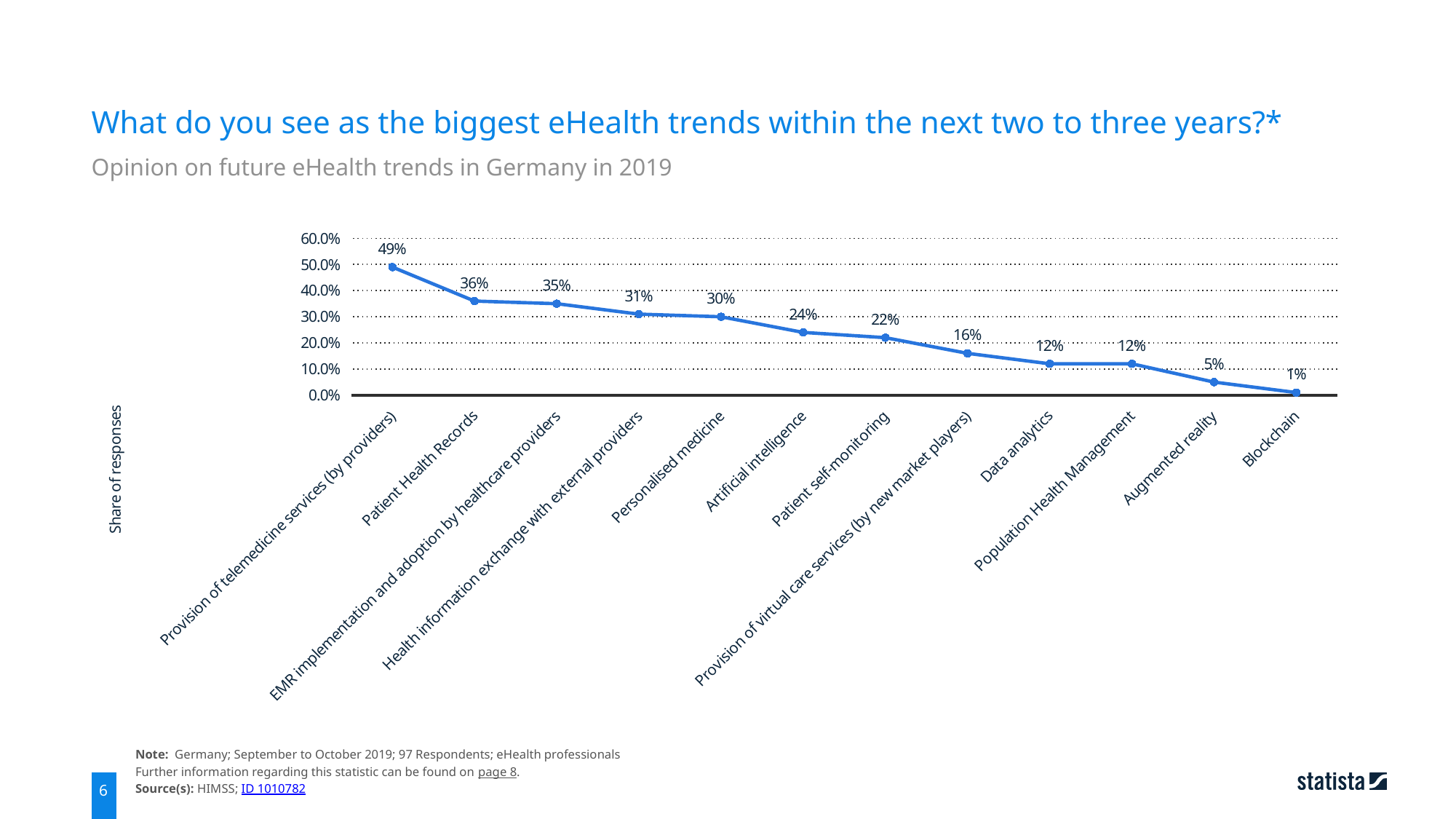
What is the difference between the share for Provision of telemedicine services (by providers) and the share for Patient Health Records? 13% What share of responses is shown for Patient Health Records? 36% Which category has the lowest share of responses? Blockchain Which category has the highest share of responses? Provision of telemedicine services (by providers) What kind of chart is shown on the slide? line chart How many categories are plotted on the chart? 12 What is the label of the vertical axis? Share of responses What share of responses is shown for Augmented reality? 5% What share of responses is shown for Artificial intelligence? 24% Do the values rise or fall from left to right along the x axis? fall Which has a larger share of responses, Personalised medicine or Patient self-monitoring? Personalised medicine Is the value for Health information exchange with external providers greater or less than 40.0%? less